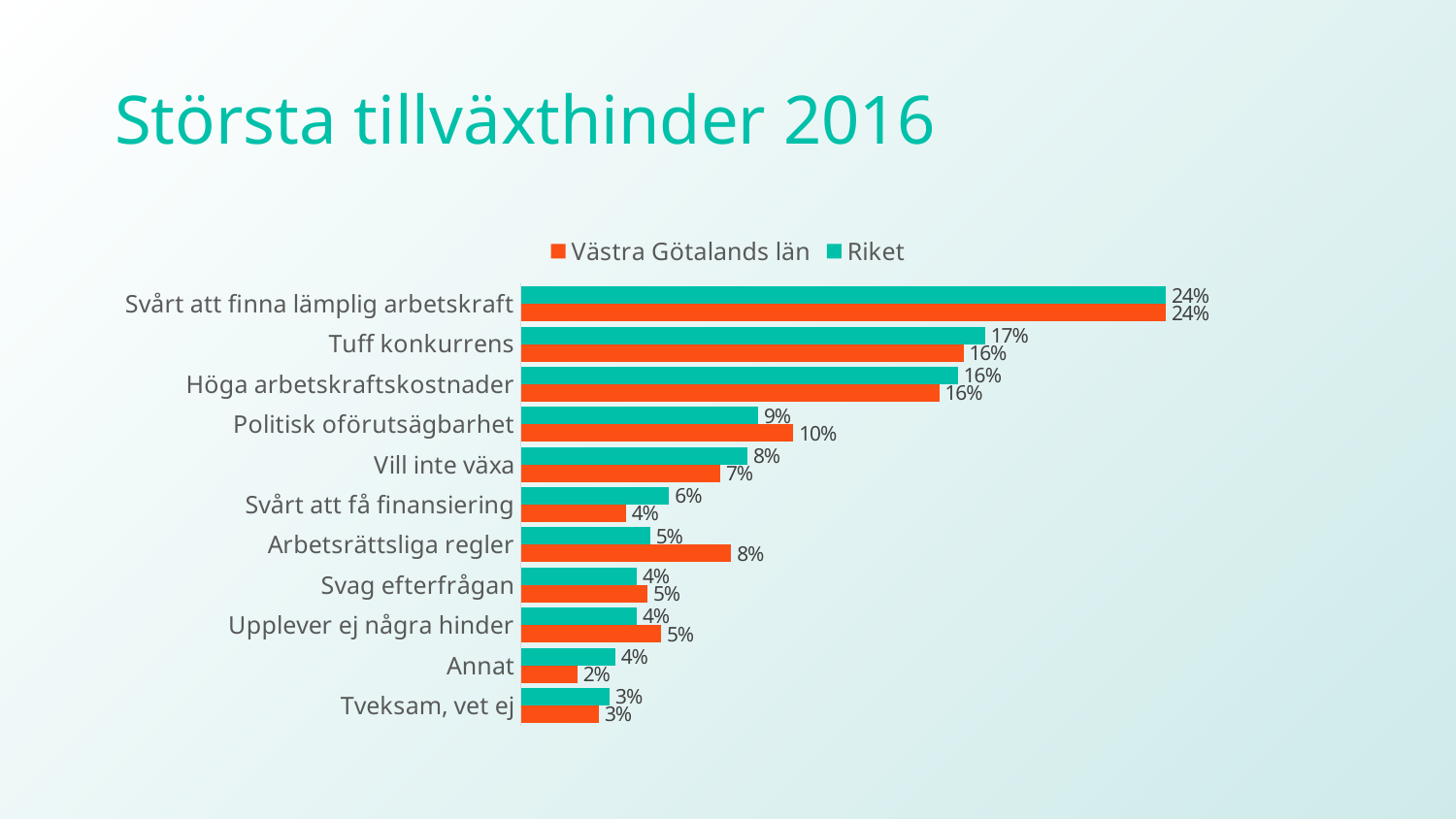
What is the value for Västra Götalands län for Arbetsrättsliga regler? 8% What is the value for Riket for Tuff konkurrens? 17% Which category has the highest value for Riket? Svårt att finna lämplig arbetskraft What is the difference between the Riket and Västra Götalands län values for Svårt att få finansiering? 2% Which colour represents the Riket series in the chart? Teal Which category has the lowest value for Västra Götalands län? Annat What is the value for Västra Götalands län for Politisk oförutsägbarhet? 10% What kind of chart is shown on the slide? Bar chart What is the title of the chart? Största tillväxthinder 2016 How many categories are shown in the chart? 11 How many series does the legend list? 2 For Arbetsrättsliga regler, which series has the larger value, Västra Götalands län or Riket? Västra Götalands län